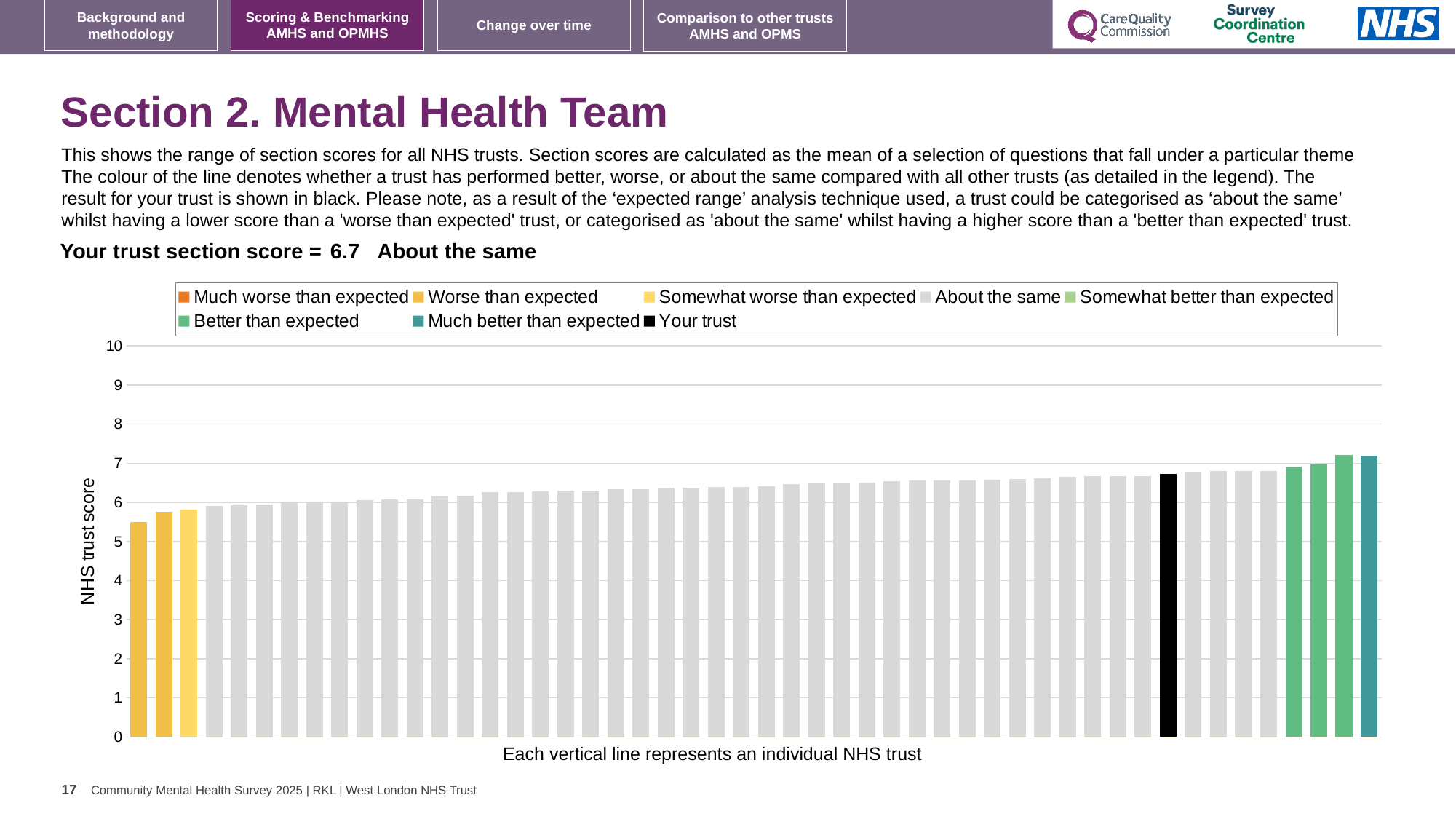
How many entries does the chart legend list? 8 What is the label on the y axis of the chart? NHS trust score What is the maximum value shown on the y axis of the chart? 10 Is the value of the black 'Your trust' bar greater or less than 6? greater What colour is the bar representing your trust in the chart? Black What is the section score for your trust shown on the slide? 6.7 Is the value of the black 'Your trust' bar greater or less than 7? less Which category does your trust fall into according to the slide? About the same Do the bar values rise or fall from left to right along the x axis? Rise What kind of chart is shown on the slide? Bar chart Is the value of the leftmost (lowest) bar greater or less than 6? less